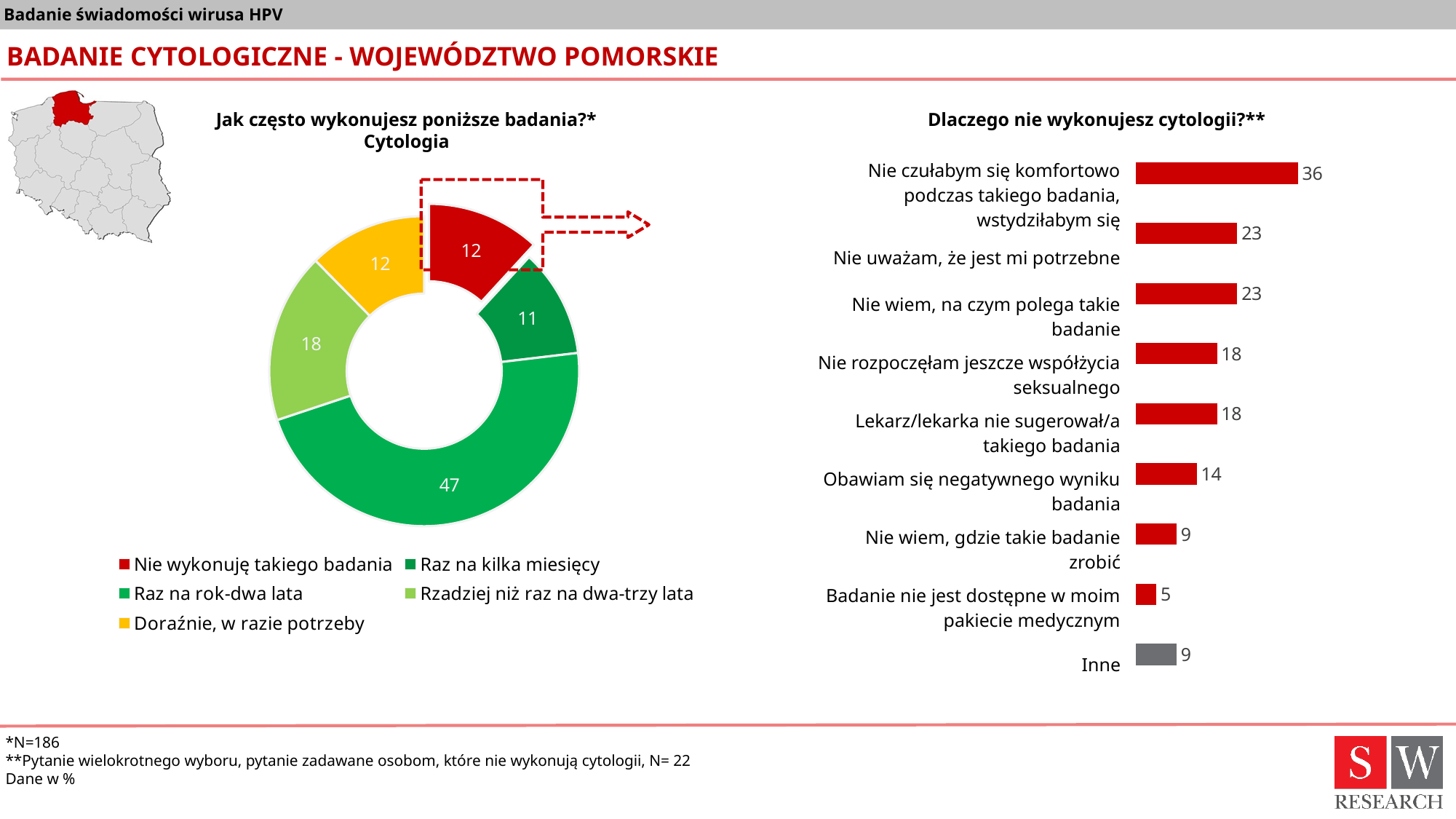
In the donut chart 'Jak często wykonujesz poniższe badania? Cytologia', what is the value for 'Raz na rok-dwa lata'? 47 In the bar chart 'Dlaczego nie wykonujesz cytologii?', which reason has the lowest value? Badanie nie jest dostępne w moim pakiecie medycznym In the donut chart 'Jak często wykonujesz poniższe badania? Cytologia', how many categories does the legend list? 5 In the donut chart 'Jak często wykonujesz poniższe badania? Cytologia', what is the value for 'Nie wykonuję takiego badania'? 12 In the donut chart 'Jak często wykonujesz poniższe badania? Cytologia', which category has the smallest value? Raz na kilka miesięcy In the bar chart 'Dlaczego nie wykonujesz cytologii?', what is the value for 'Obawiam się negatywnego wyniku badania'? 14 In the bar chart 'Dlaczego nie wykonujesz cytologii?', how many bars are shown? 9 In the donut chart 'Jak często wykonujesz poniższe badania? Cytologia', which category has the largest value? Raz na rok-dwa lata In the bar chart 'Dlaczego nie wykonujesz cytologii?', which is larger: 'Nie uważam, że jest mi potrzebne' or 'Nie rozpoczęłam jeszcze współżycia seksualnego'? Nie uważam, że jest mi potrzebne What type of chart is 'Dlaczego nie wykonujesz cytologii?'? Bar chart In the bar chart 'Dlaczego nie wykonujesz cytologii?', what is the value for 'Nie czułabym się komfortowo podczas takiego badania, wstydziłabym się'? 36 In the donut chart 'Jak często wykonujesz poniższe badania? Cytologia', what is the difference between 'Raz na rok-dwa lata' and 'Rzadziej niż raz na dwa-trzy lata'? 29